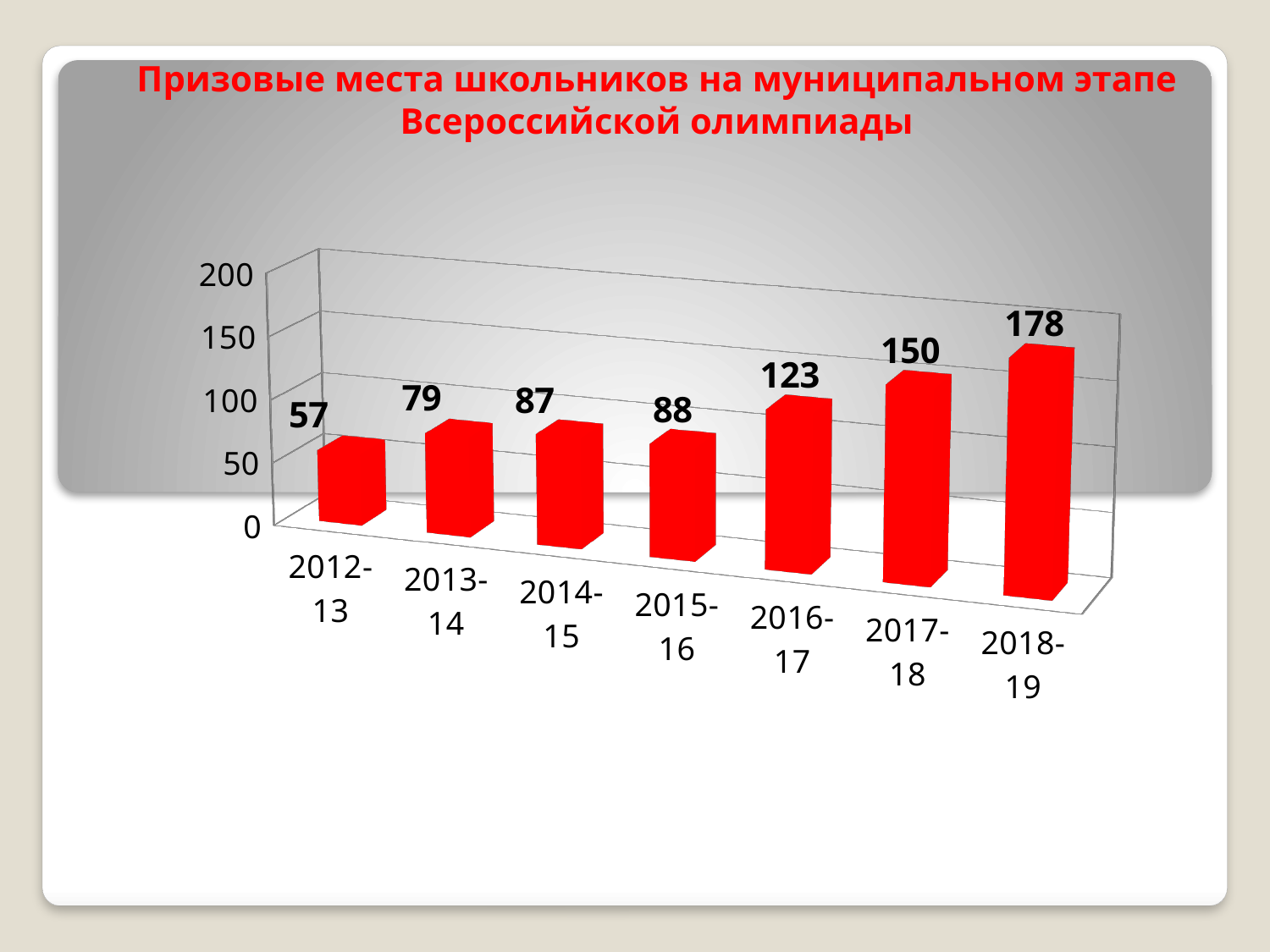
What is the value for 2016-17? 123 What is the difference between the values for 2013-14 and 2012-13? 22 What is the value for 2018-19? 178 Is the value for 2017-18 greater or less than 100? greater What is the value for 2012-13? 57 Do the values rise or fall from 2012-13 to 2018-19? rise Which is larger, the value for 2014-15 or the value for 2015-16? 2015-16 Which year has the highest value? 2018-19 What is the difference between the values for 2018-19 and 2017-18? 28 How many years are shown on the chart? 7 What kind of chart is shown on the slide? bar chart Which year has the lowest value? 2012-13